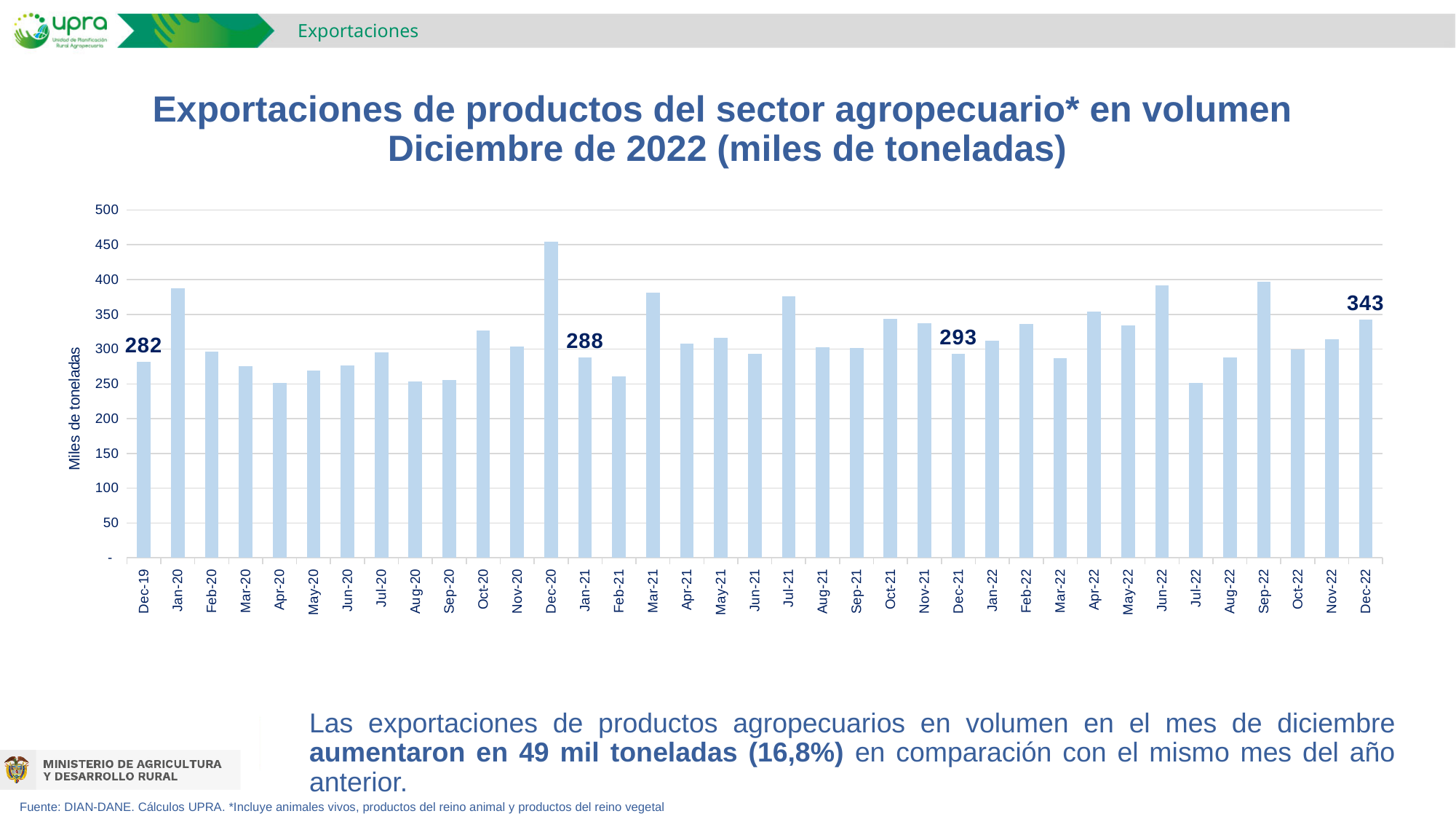
What is the value for Dec-21? 293 What kind of chart is shown on the slide? bar chart How many months are plotted on the chart? 37 Which is larger, the value for Dec-22 or the value for Dec-21? Dec-22 What is the label of the vertical axis? Miles de toneladas Which month has the highest value? Dec-20 What is the value for Dec-22? 343 What is the difference between the values for Dec-22 and Dec-19? 61 Is the value for Apr-20 greater or less than 300? less What is the value for Jan-21? 288 What is the value for Dec-19? 282 Is the value for Dec-20 greater or less than 400? greater